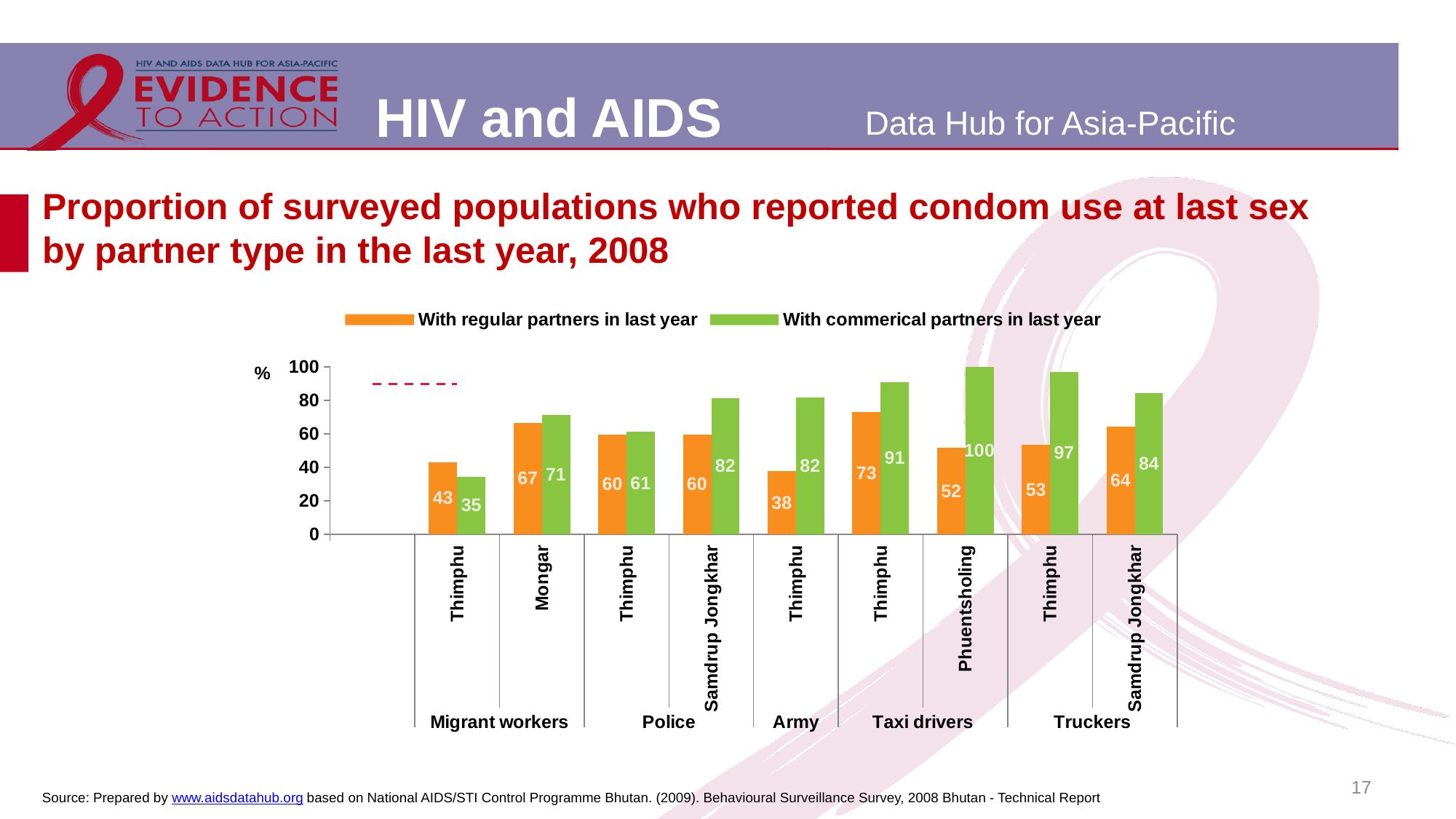
How many series does the legend list? 2 Which group has the highest value for condom use with commercial partners in the last year? Taxi drivers, Phuentsholing For migrant workers in Thimphu, which is larger: condom use with regular partners or with commercial partners? With regular partners What is the value for condom use with commercial partners among taxi drivers in Phuentsholing? 100 What type of chart is shown on the slide? bar chart What is the difference between commercial and regular partner condom use for the army in Thimphu? 44 What is the value for condom use with regular partners among the army in Thimphu? 38 Which group has the lowest value for condom use with regular partners in the last year? Army, Thimphu What is the difference between commercial and regular partner condom use for truckers in Thimphu? 44 How many location groups are shown along the x axis? 9 What is the value for condom use with regular partners among migrant workers in Thimphu? 43 Which colour represents condom use with commercial partners in the last year? Green